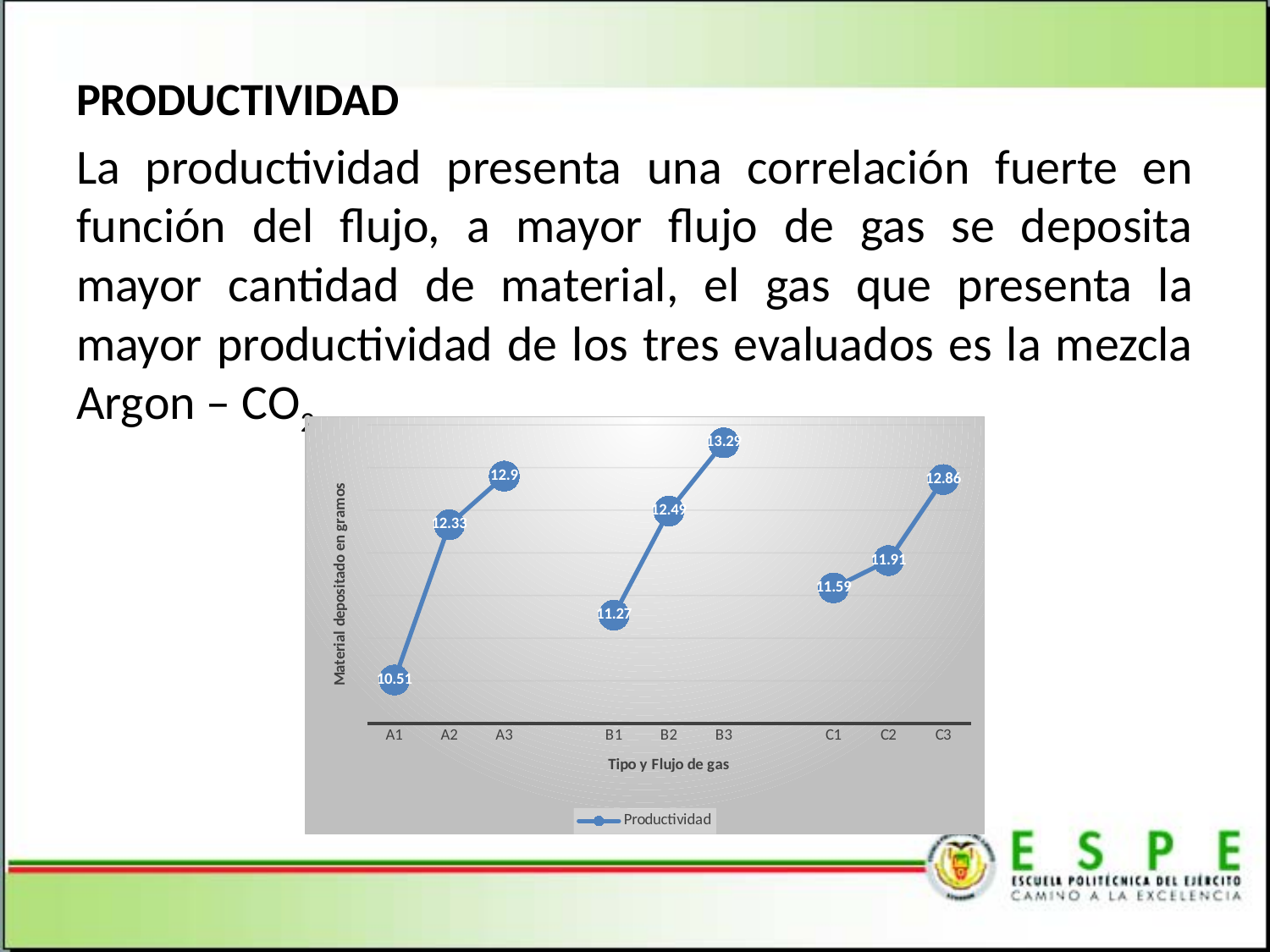
Which is larger, the value for A3 or the value for C3? A3 What is the difference between the values for B3 and B1? 2.02 What kind of chart is shown on the slide? Line chart Which category has the highest value in the Productividad chart? B3 How many series does the legend list? 1 What is the value for A1 in the Productividad chart? 10.51 What is the value for C2 in the Productividad chart? 11.91 Which category has the lowest value in the Productividad chart? A1 What is the difference between the values for A3 and A1? 2.39 What is the title of the x axis of the chart? Tipo y Flujo de gas What is the value for B3 in the Productividad chart? 13.29 How many data points are plotted in the chart? 9